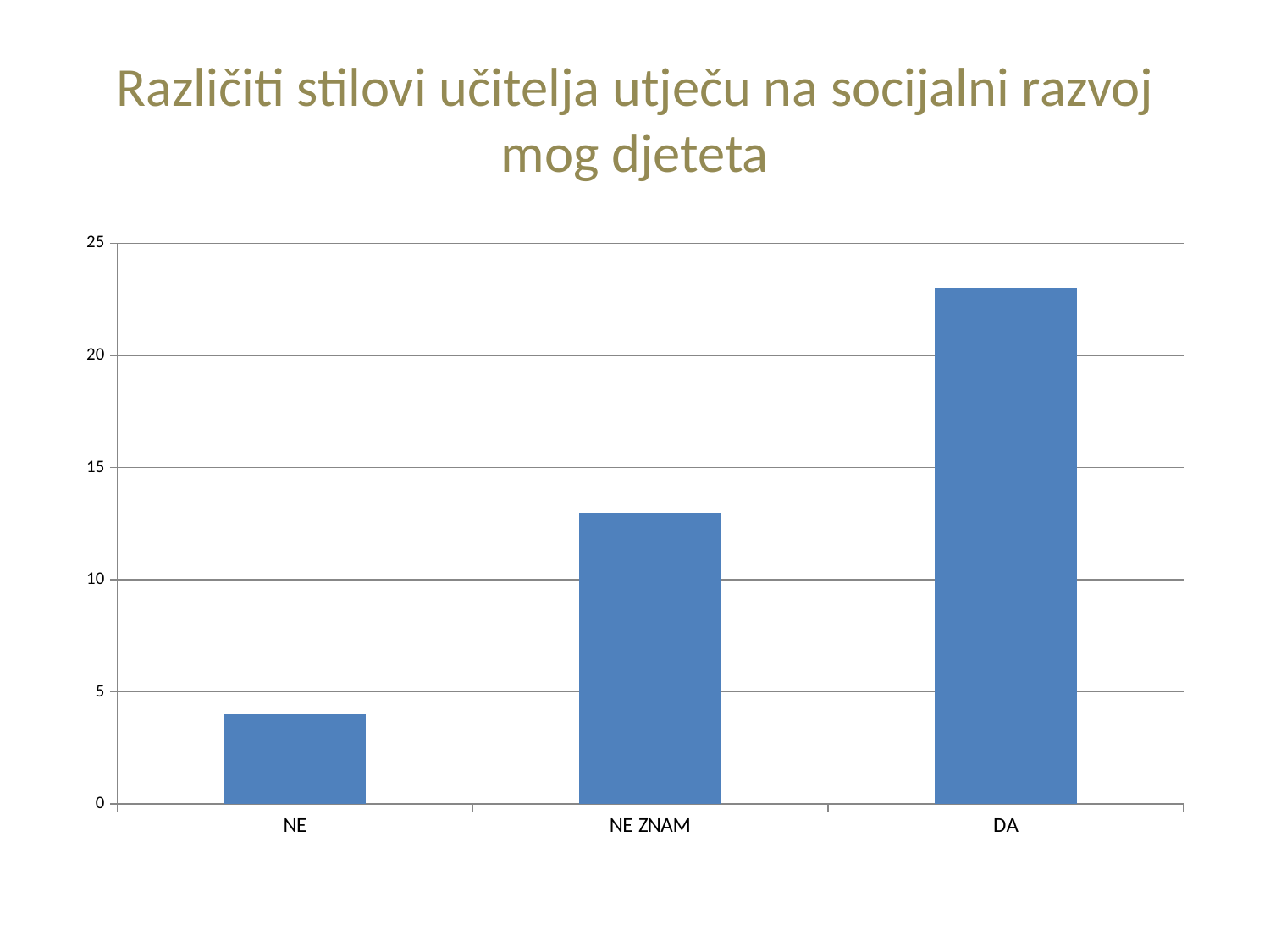
Which category has the highest bar? DA How many categories are shown on the x axis of the chart? 3 Is the value for DA greater or less than 25? less Is the value for DA greater or less than 20? greater Is the value for NE ZNAM greater or less than 10? greater Which is larger, the value for NE ZNAM or the value for DA? DA Do the bar values rise or fall from left to right along the x axis? rise What kind of chart is shown on the slide? bar chart What is the title of the slide containing the chart? Različiti stilovi učitelja utječu na socijalni razvoj mog djeteta Which category has the lowest bar? NE